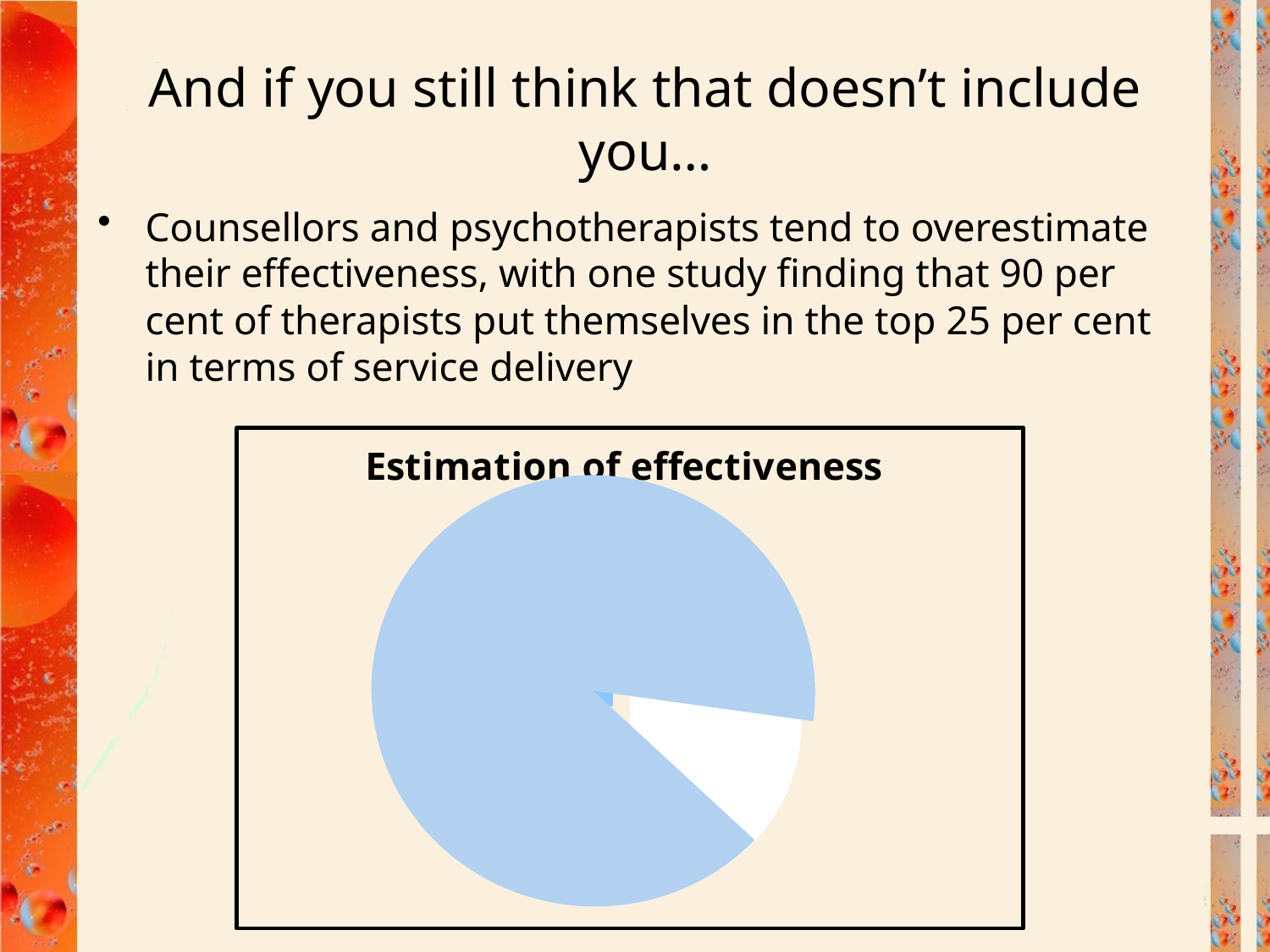
What kind of chart is shown on the slide? pie chart What colour is the largest slice of the pie chart? blue Which slice of the pie chart is the smallest? the white slice What is the title of the chart? Estimation of effectiveness Which slice of the pie chart is the largest? the blue slice How many slices does the pie chart have? 2 Which slice of the pie chart is larger, the blue slice or the white slice? the blue slice